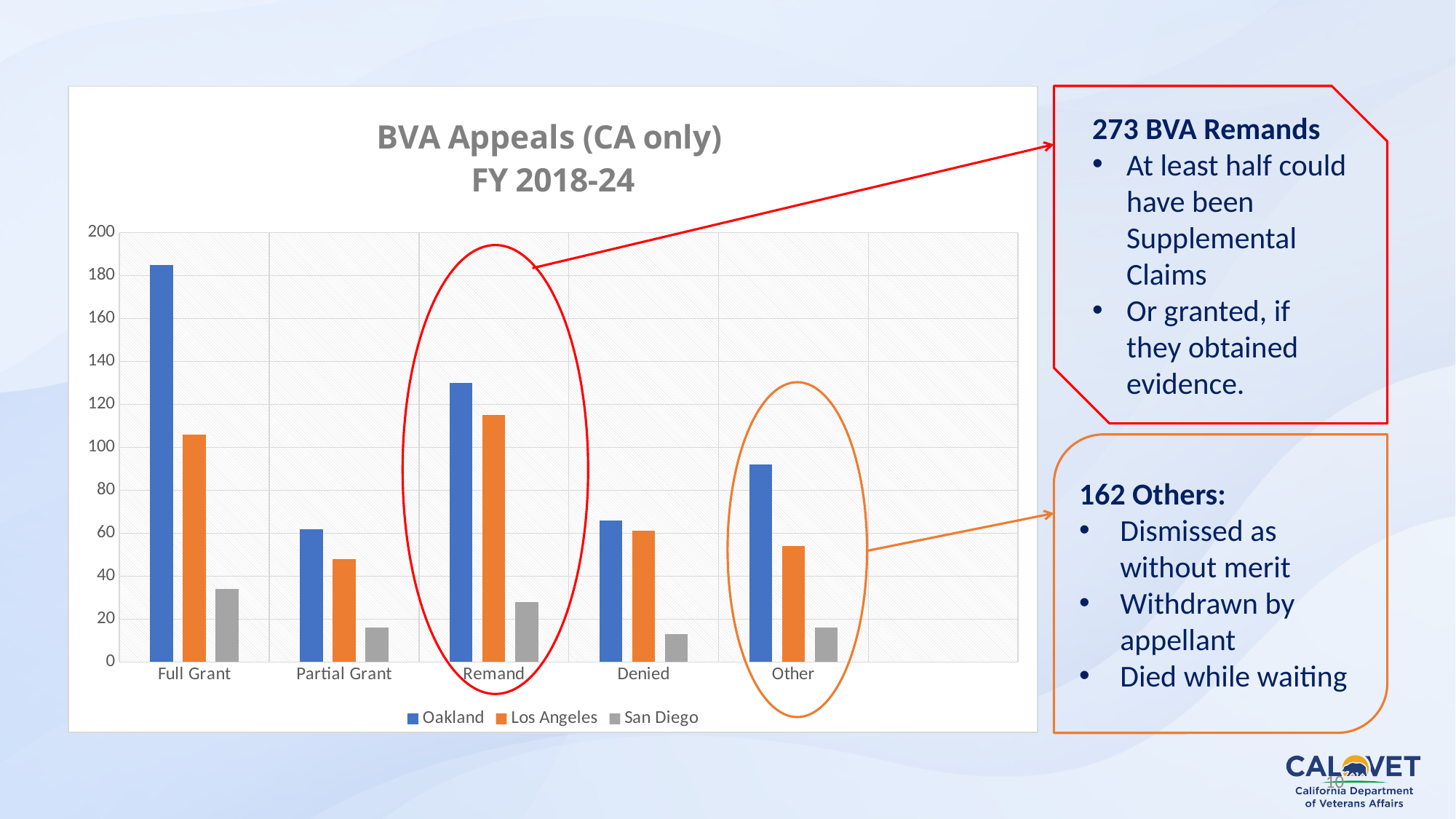
How many categories are shown on the x axis of the BVA Appeals chart? 5 How many series does the legend of the BVA Appeals chart list? 3 What is the title of the chart? BVA Appeals (CA only) FY 2018-24 Which series has the lowest bar in the Full Grant category? San Diego In the Remand category, which is larger, the Oakland bar or the San Diego bar? Oakland In the Other category, which is larger, the Oakland bar or the Los Angeles bar? Oakland Which category has the highest Oakland bar? Full Grant Is the San Diego value for Full Grant greater or less than 40? less What kind of chart is shown on the slide? bar chart Is the Los Angeles value for Remand greater or less than 100? greater Is the Oakland value for Partial Grant greater or less than 80? less